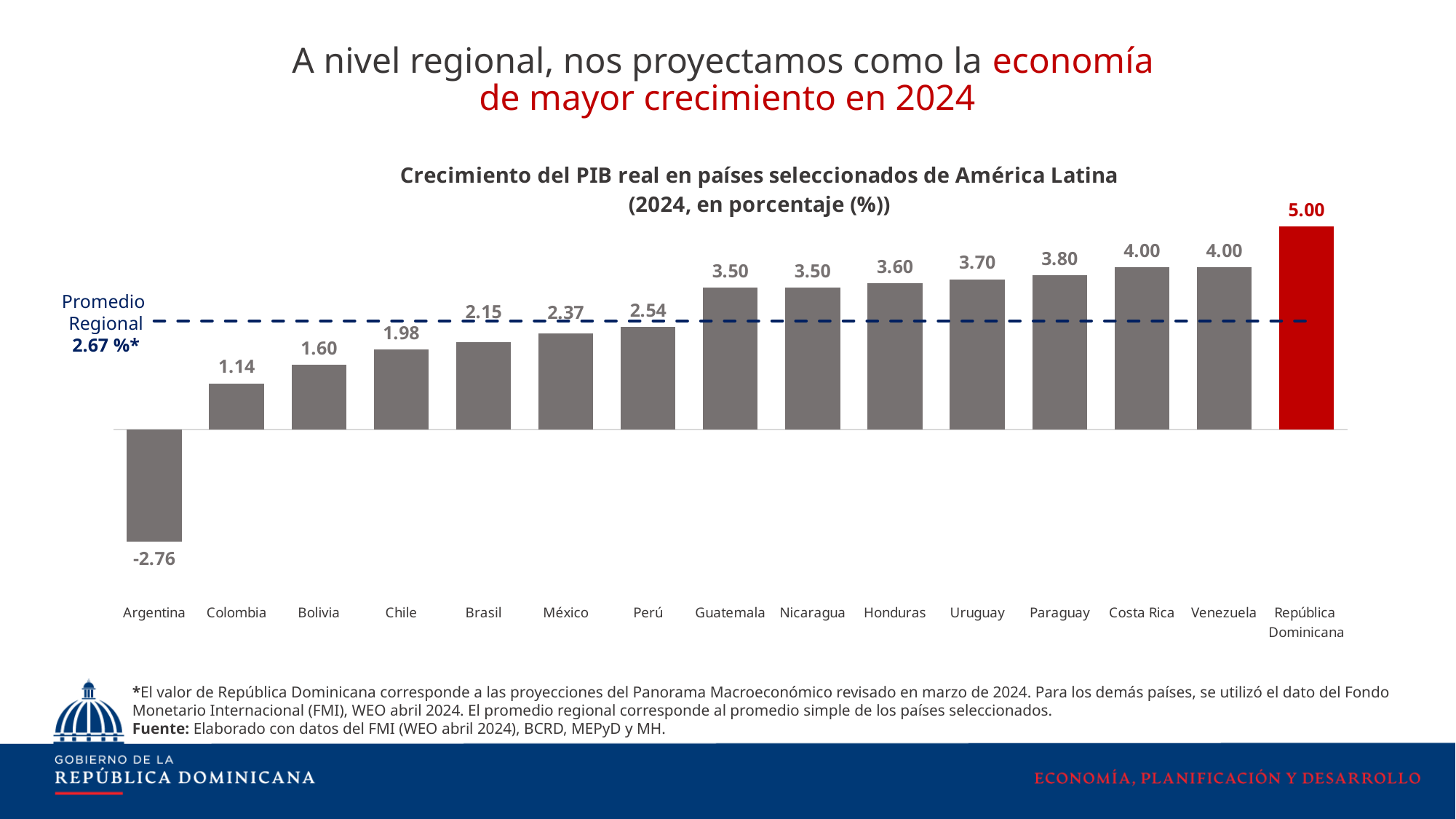
Which has a larger value, Honduras or Brasil? Honduras Which country has the lowest projected growth in the chart? Argentina Which country's bar is highlighted in red? República Dominicana Which country has the highest projected growth in the chart? República Dominicana What is the difference between the values for República Dominicana and Venezuela? 1.00 How many countries are shown in the chart? 15 What is the value shown for Argentina? -2.76 What is the projected 2024 real GDP growth for República Dominicana? 5.00 What type of chart is shown on the slide? Bar chart What is the value shown for Perú? 2.54 What is the difference between the values for Colombia and Bolivia? 0.46 What is the regional average (Promedio Regional) indicated by the dashed line? 2.67 %*